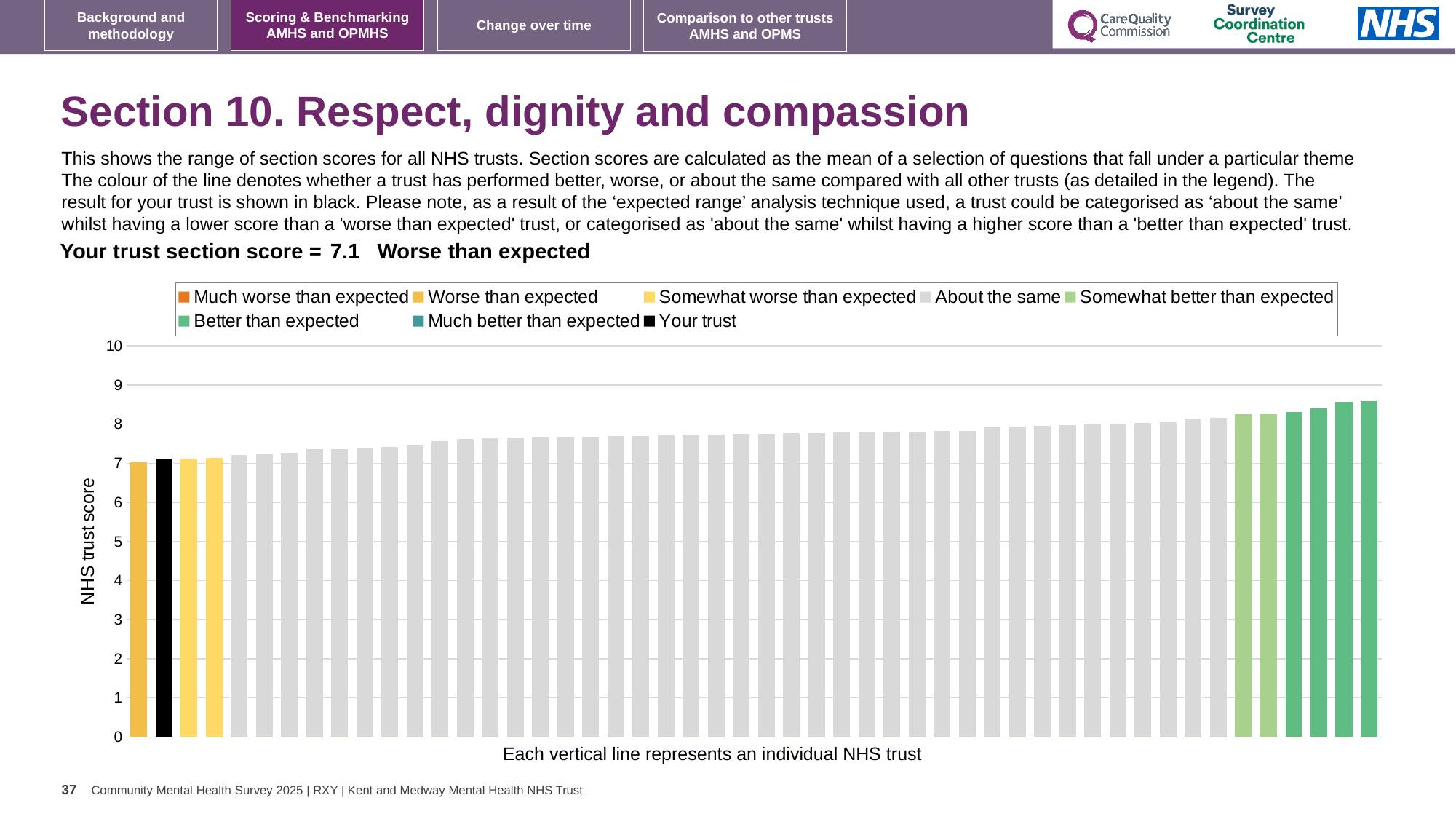
Is the value for your trust (the black bar) greater or less than 5? greater What kind of chart is shown on the slide? bar chart Is the value for the rightmost bar greater or less than 8? greater Is the value for your trust (the black bar) greater or less than 8? less Is the leftmost bar higher or lower than the rightmost bar? lower What colour is the bar representing your trust? black What is the section score for your trust shown on the slide? 7.1 Do the bar values rise or fall from left to right across the chart? rise Is the black bar for your trust higher or lower than the rightmost bar? lower What is the label on the vertical axis of the chart? NHS trust score How many entries does the chart legend list? 8 Which performance category is your trust placed in for Section 10? Worse than expected